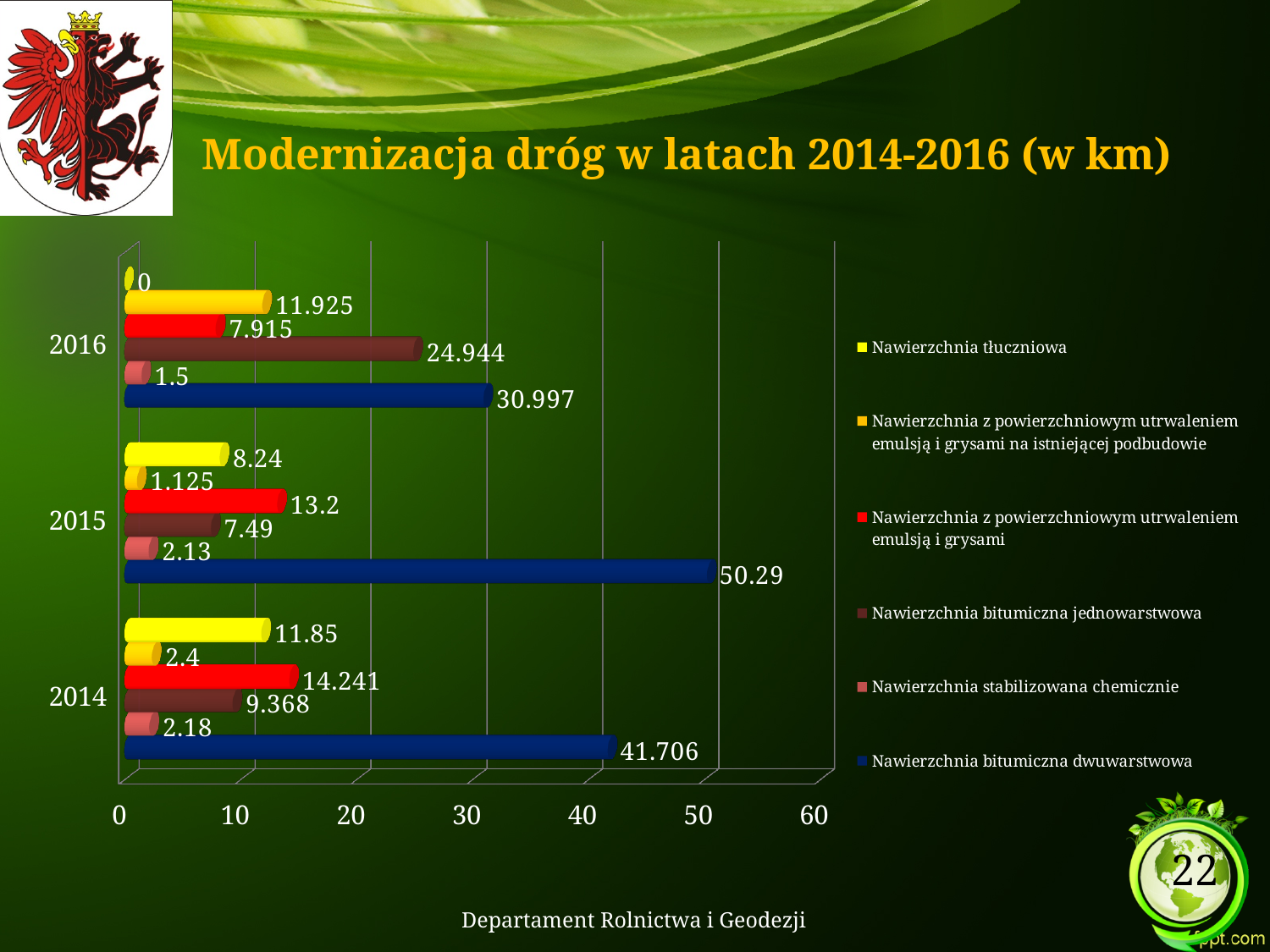
What is the value for Nawierzchnia stabilizowana chemicznie in 2014? 2.18 What is the value for Nawierzchnia bitumiczna jednowarstwowa in 2016? 24.944 In which year is the value for Nawierzchnia bitumiczna jednowarstwowa the lowest? 2015 In which year is the value for Nawierzchnia bitumiczna dwuwarstwowa the highest? 2015 What is the value for Nawierzchnia tłuczniowa in 2016? 0 What type of chart is shown on the slide? bar chart What is the title of the chart? Modernizacja dróg w latach 2014-2016 (w km) How many series does the legend list? 6 What is the value for Nawierzchnia bitumiczna dwuwarstwowa in 2015? 50.29 How many year categories are shown on the vertical axis? 3 What is the difference between the Nawierzchnia bitumiczna dwuwarstwowa values for 2015 and 2014? 8.584 Which is larger: Nawierzchnia z powierzchniowym utrwaleniem emulsją i grysami in 2014 or in 2016? 2014